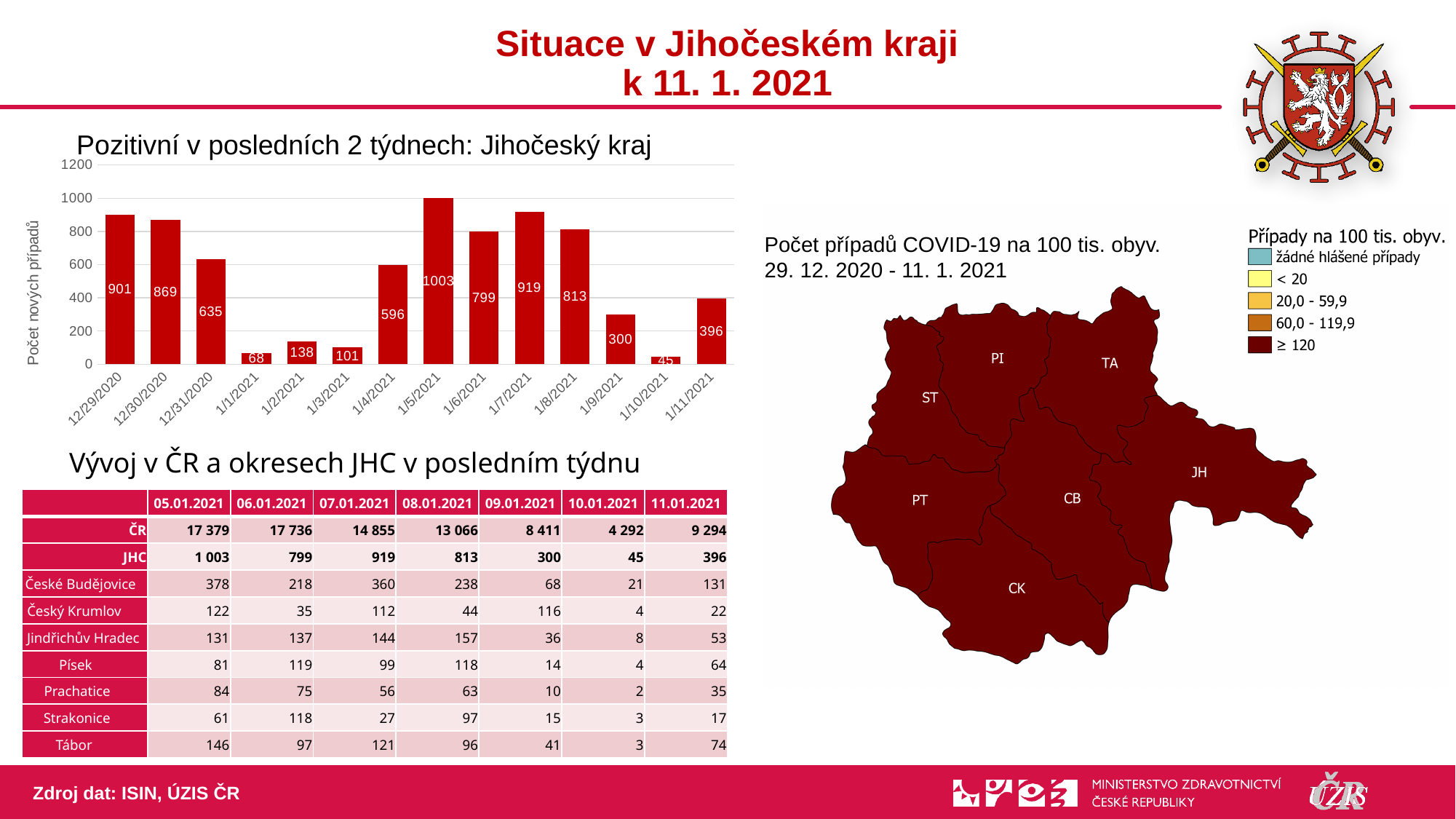
Which date has the highest value in the bar chart? 1/5/2021 What is the y-axis label of the bar chart? Počet nových případů Is the value for 1/4/2021 in the bar chart greater or less than 400? greater Do the values in the bar chart rise or fall from 12/29/2020 to 1/1/2021? fall What is the difference between the values for 1/7/2021 and 1/6/2021 in the bar chart? 120 What type of chart is shown under the title "Pozitivní v posledních 2 týdnech: Jihočeský kraj"? bar chart What is the value for 1/10/2021 in the bar chart? 45 Which date has the lowest value in the bar chart? 1/10/2021 Which is larger in the bar chart, the value for 12/30/2020 or the value for 1/8/2021? 12/30/2020 What is the value for 1/5/2021 in the bar chart? 1003 How many bars are in the bar chart? 14 What is the value for 12/29/2020 in the bar chart? 901